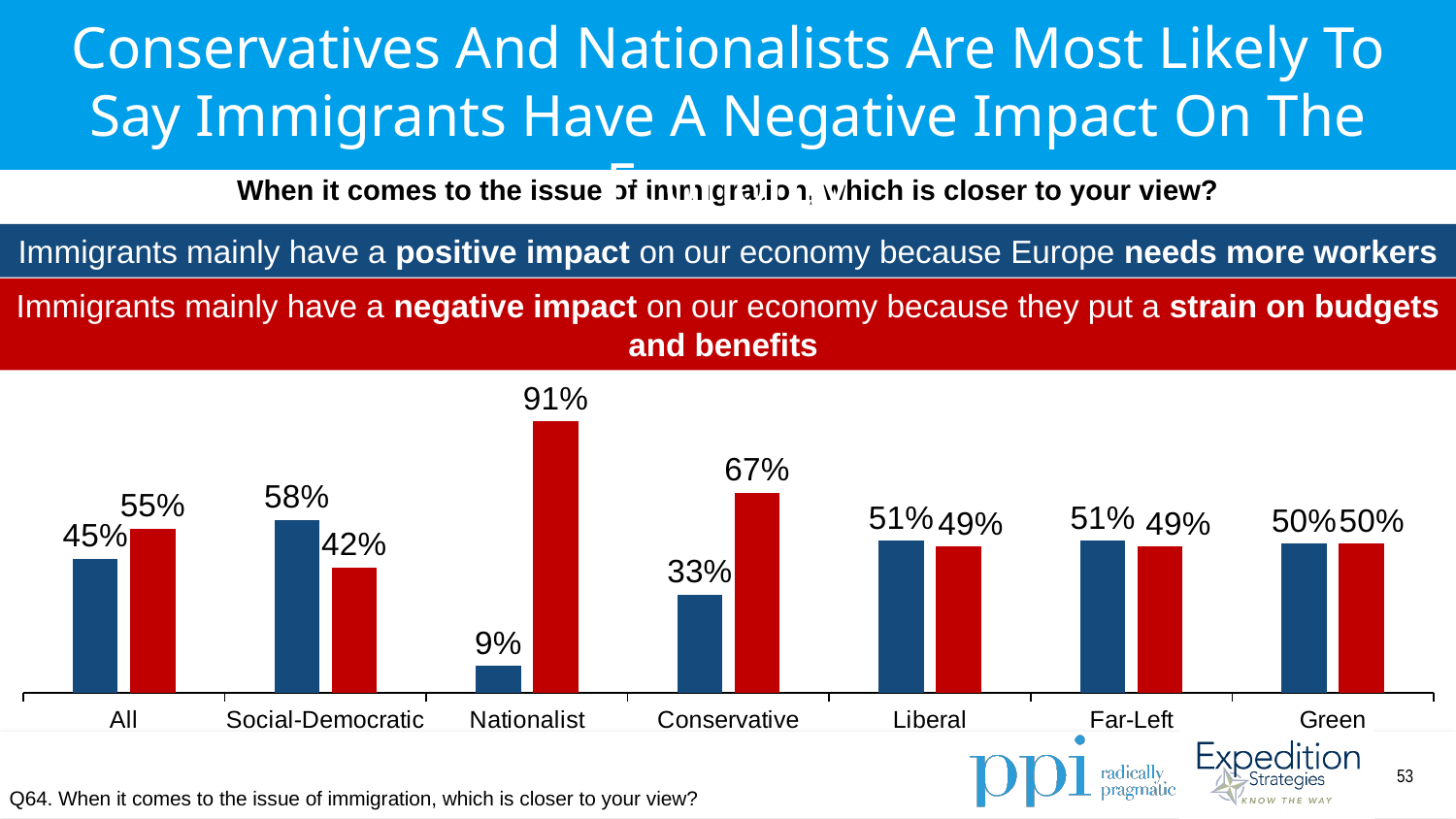
Which category has the lowest blue (positive impact) bar? Nationalist What is the value of the red (negative impact) bar for the All category? 55% How many series (bar colours) does the chart plot for each category? 2 Which category has the highest red (negative impact) bar? Nationalist What is the difference between the red and blue bars for Conservative respondents? 34 percentage points What type of chart is shown on the slide? bar chart For Social-Democratic respondents, which bar is larger, the blue (positive impact) or the red (negative impact)? blue (positive impact) What is the value of both bars for the Green category? 50% What is the value of the blue (positive impact) bar for Social-Democratic respondents? 58% How many categories are shown along the x axis of the chart? 7 What percentage of Conservative respondents say immigrants mainly have a positive impact (blue bar)? 33% What percentage of Nationalist respondents say immigrants mainly have a negative impact on the economy (red bar)? 91%